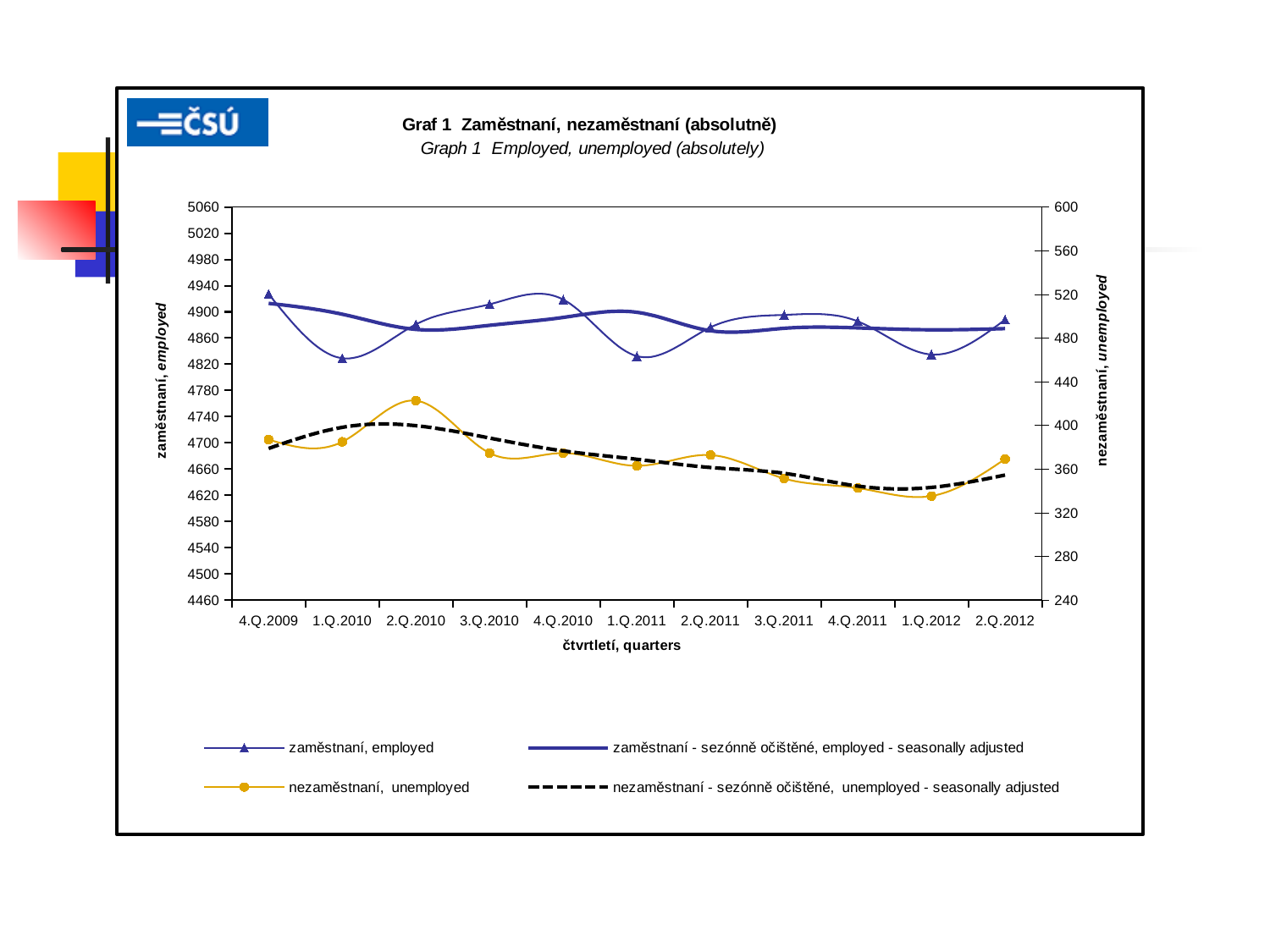
Is the value of the 'zaměstnaní, employed' series for 1.Q.2010 greater or less than 4860? less Which is larger for the 'nezaměstnaní, unemployed' series: the value for 2.Q.2010 or the value for 1.Q.2012? 2.Q.2010 Is the value of the 'zaměstnaní, employed' series for 4.Q.2009 greater or less than 4900? greater How many series does the chart's legend list? 4 In which quarter is the 'nezaměstnaní, unemployed' series lowest? 1.Q.2012 How many quarters are shown on the x axis of the chart? 11 What kind of chart is shown on the slide? line chart Does the 'nezaměstnaní, unemployed' series rise or fall from 2.Q.2010 to 1.Q.2012? fall In which quarter is the 'nezaměstnaní, unemployed' series highest? 2.Q.2010 Is the value of the 'nezaměstnaní, unemployed' series for 2.Q.2010 greater or less than 400? greater What is the English title of the chart? Graph 1 Employed, unemployed (absolutely)